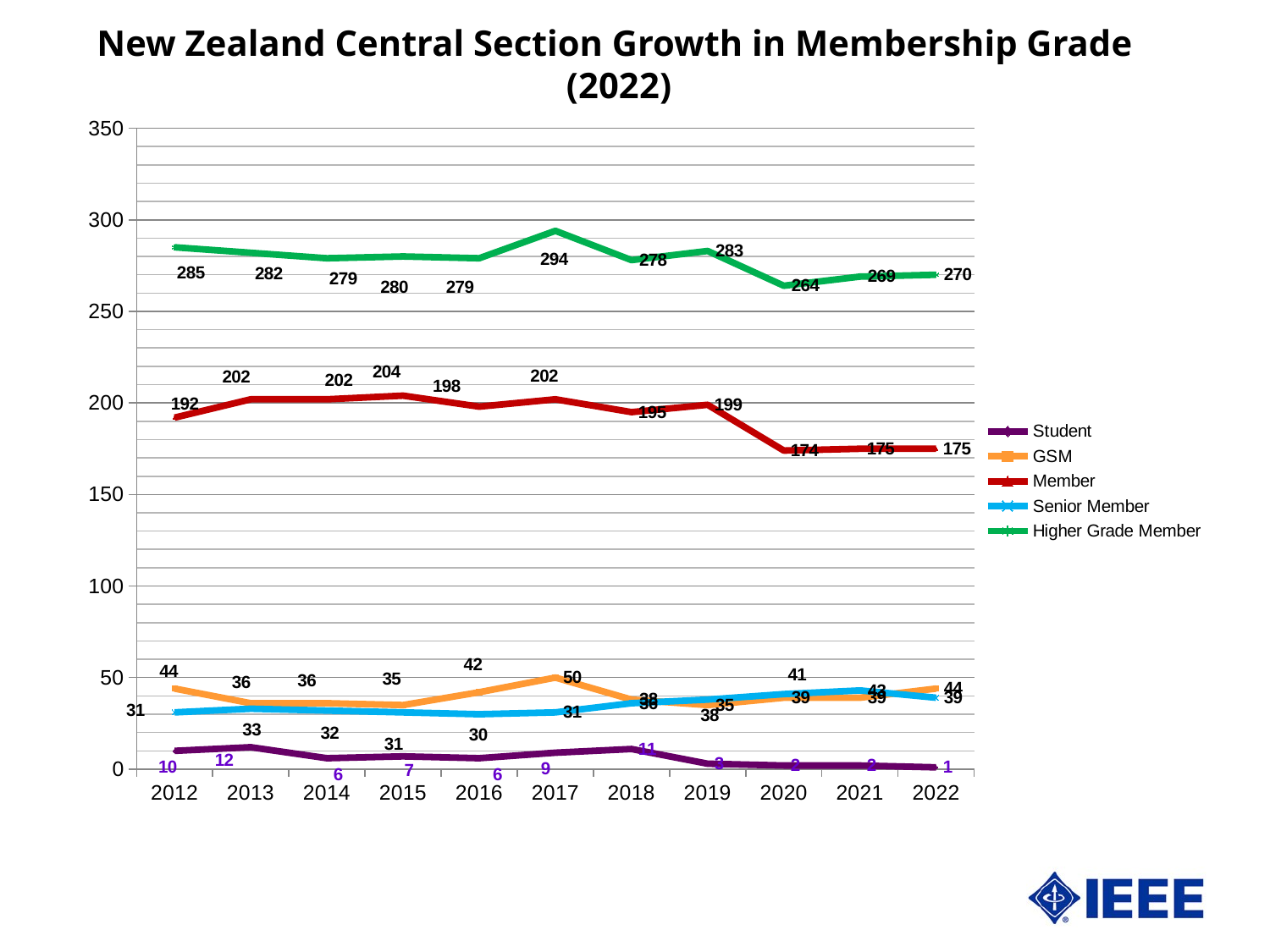
What is the value for Higher Grade Member in 2017? 294 What is the value for GSM in 2017? 50 What type of chart is shown on the slide? Line chart What is the value for Student in 2022? 1 In which year is the Member value highest? 2015 Does the Member value rise or fall from 2019 to 2020? Fall What is the difference between the Higher Grade Member values in 2012 and 2022? 15 In which year is the Higher Grade Member value lowest? 2020 How many years are plotted along the x axis? 11 What is the value for Member in 2020? 174 How many series does the legend list? 5 Which is larger, the Member value in 2012 or in 2013? 2013